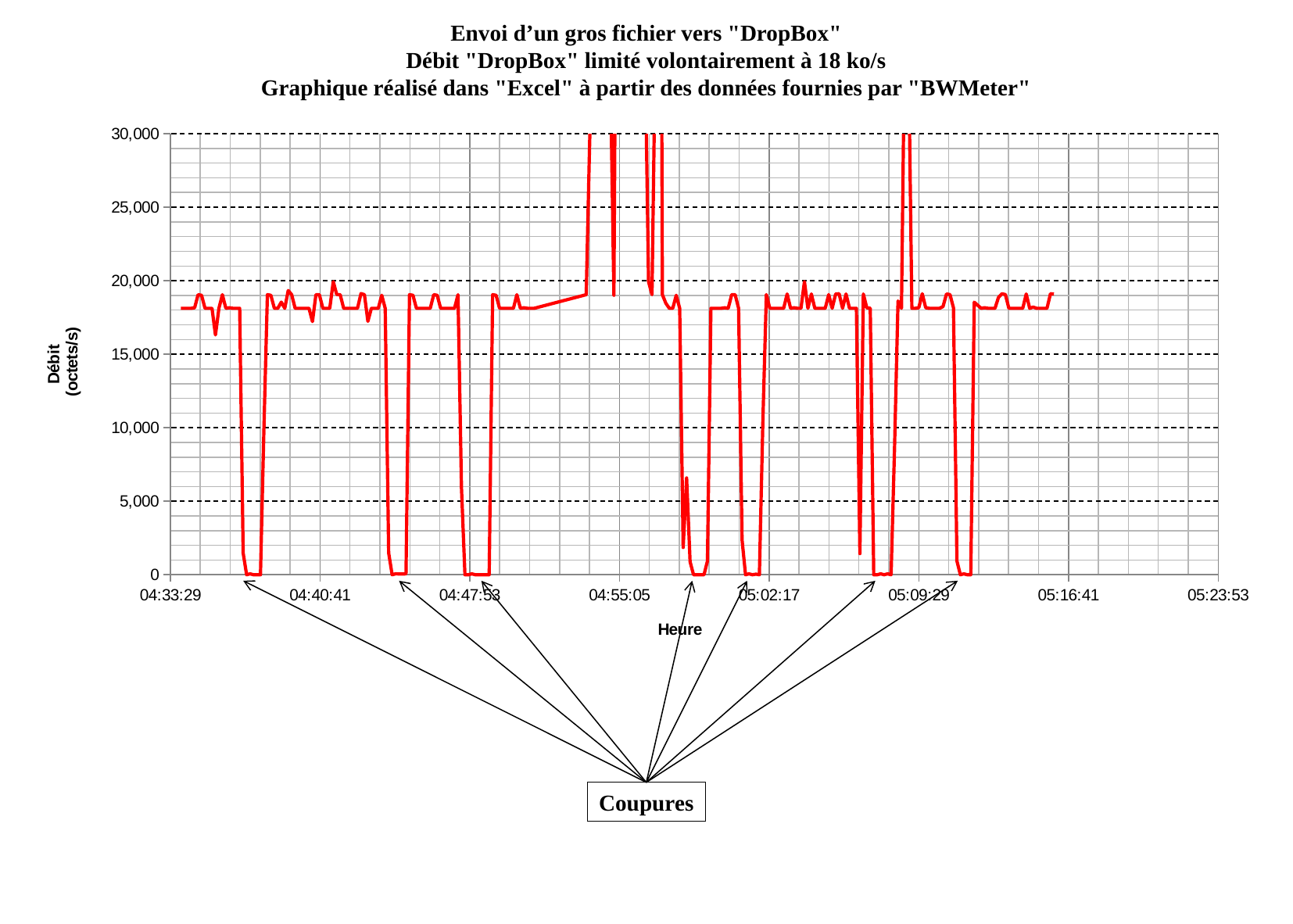
What is the first line of the chart title? Envoi d'un gros fichier vers "DropBox" What kind of chart is shown on the slide? line chart Is the value at 04:40:41 greater or less than 15,000? greater Is the value at 05:09:29 greater or less than 10,000? greater How many "Coupures" (cut-offs) are pointed out by arrows on the chart? 7 What is the label of the vertical axis? Débit (octets/s) Is the value at 04:47:53 greater or less than 5,000? less